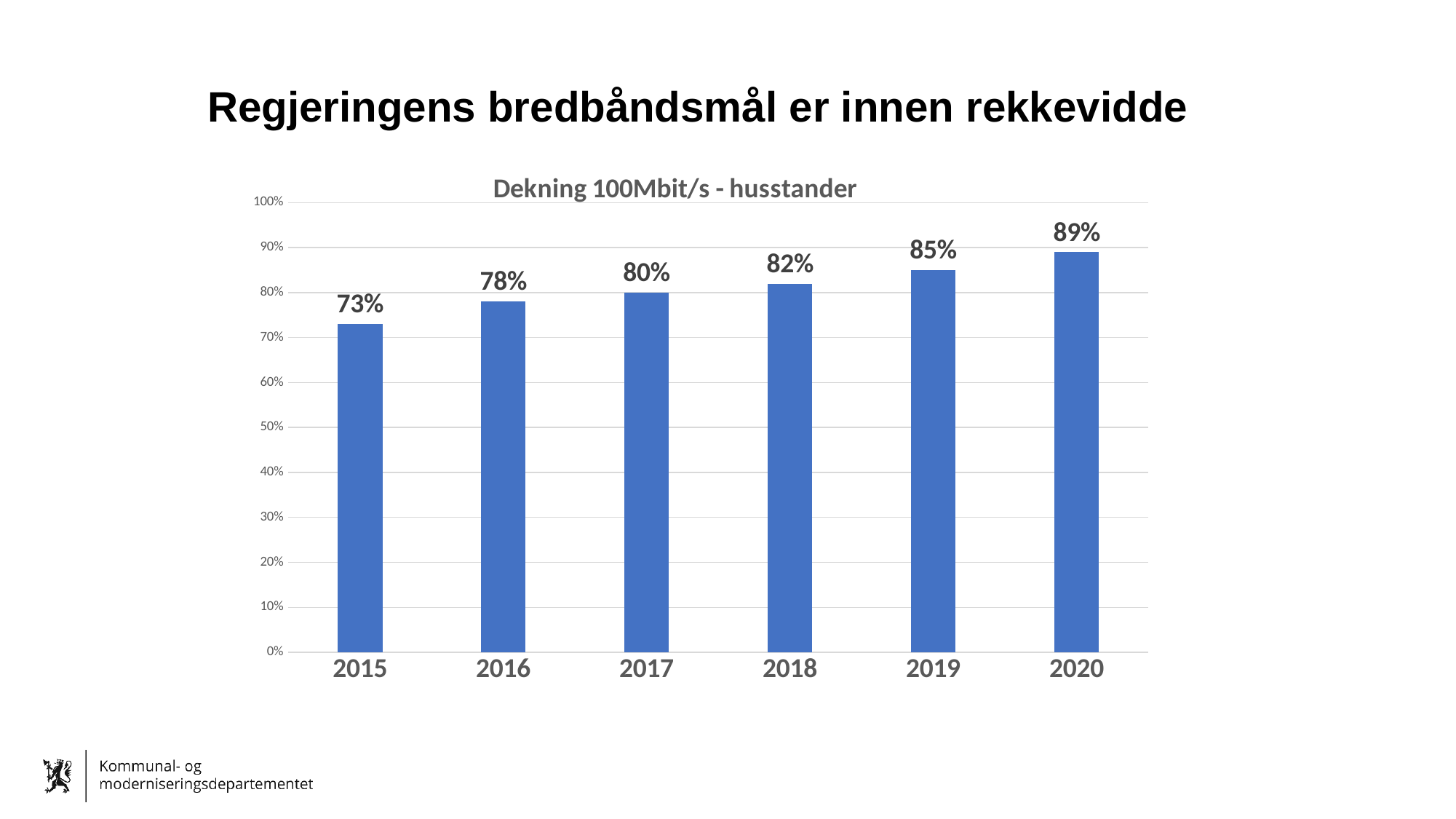
What is the value for 2018? 82% What is the difference between the values for 2019 and 2017? 5% What is the value for 2015? 73% How many years are shown on the x axis? 6 What kind of chart is shown on the slide? Bar chart What is the value for 2020? 89% Do the values rise or fall from 2015 to 2020? Rise What is the difference between the values for 2020 and 2015? 16% Which is larger, the value for 2016 or the value for 2019? 2019 Is the value for 2017 greater or less than 70%? greater Which year has the lowest value? 2015 Which year has the highest value? 2020